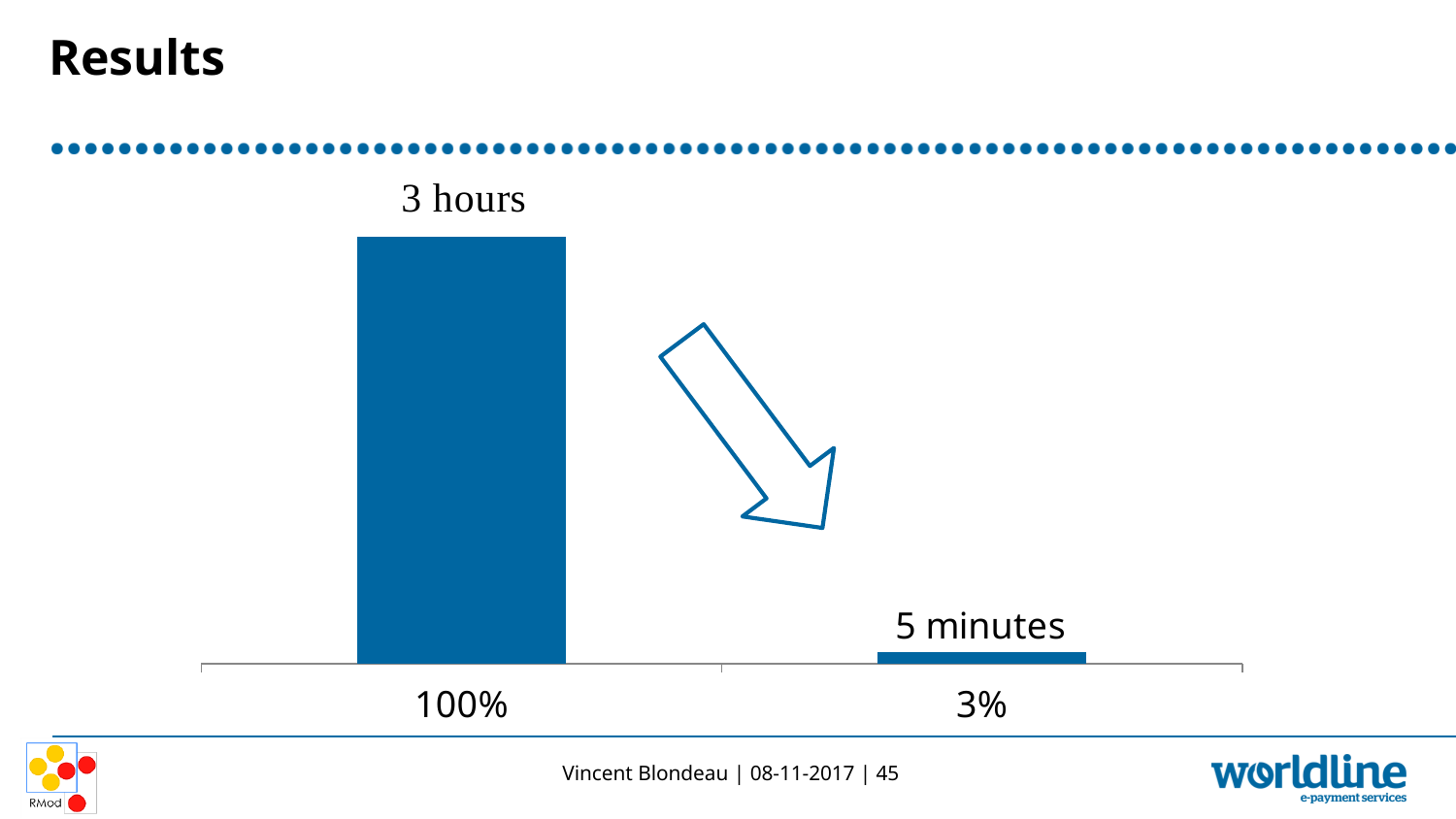
Which category has the tallest bar? 100% Which category has the shortest bar? 3% What is the title of the slide containing the chart? Results What is the data label on the bar for the 3% category? 5 minutes Which bar is taller, the one for 100% or the one for 3%? 100% How many bars does the chart show? 2 Do the bar values rise or fall from left to right along the x axis? fall What kind of chart is shown on the slide? bar chart What are the two category labels shown on the x axis? 100% and 3% What is the data label on the bar for the 100% category? 3 hours